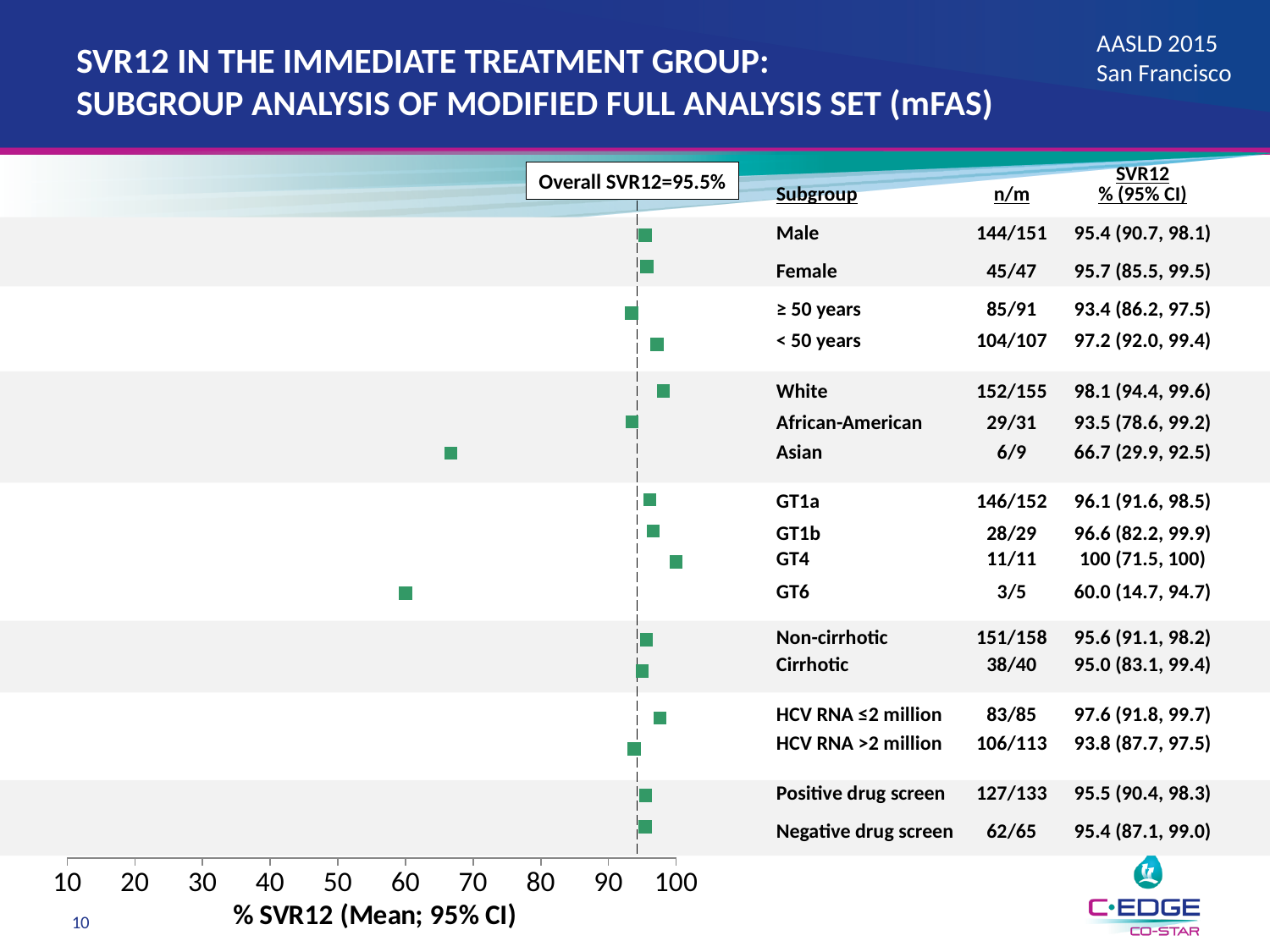
Which has a higher SVR12 %, HCV RNA ≤2 million or HCV RNA >2 million? HCV RNA ≤2 million What is the SVR12 % for the Asian subgroup? 66.7 Is the SVR12 value for the GT6 subgroup greater or less than 70? less What is the difference in SVR12 % between the < 50 years and ≥ 50 years subgroups? 3.8 What kind of chart is shown on the slide? forest plot How many subgroups are plotted in the chart? 17 What is the difference in SVR12 % between the White and African-American subgroups? 4.6 What is the SVR12 % for the Male subgroup? 95.4 Which subgroup has the highest SVR12 %? GT4 What overall SVR12 value is shown in the box above the chart? 95.5% Which subgroup has the lowest SVR12 %? GT6 What is the n/m value for the GT6 subgroup? 3/5